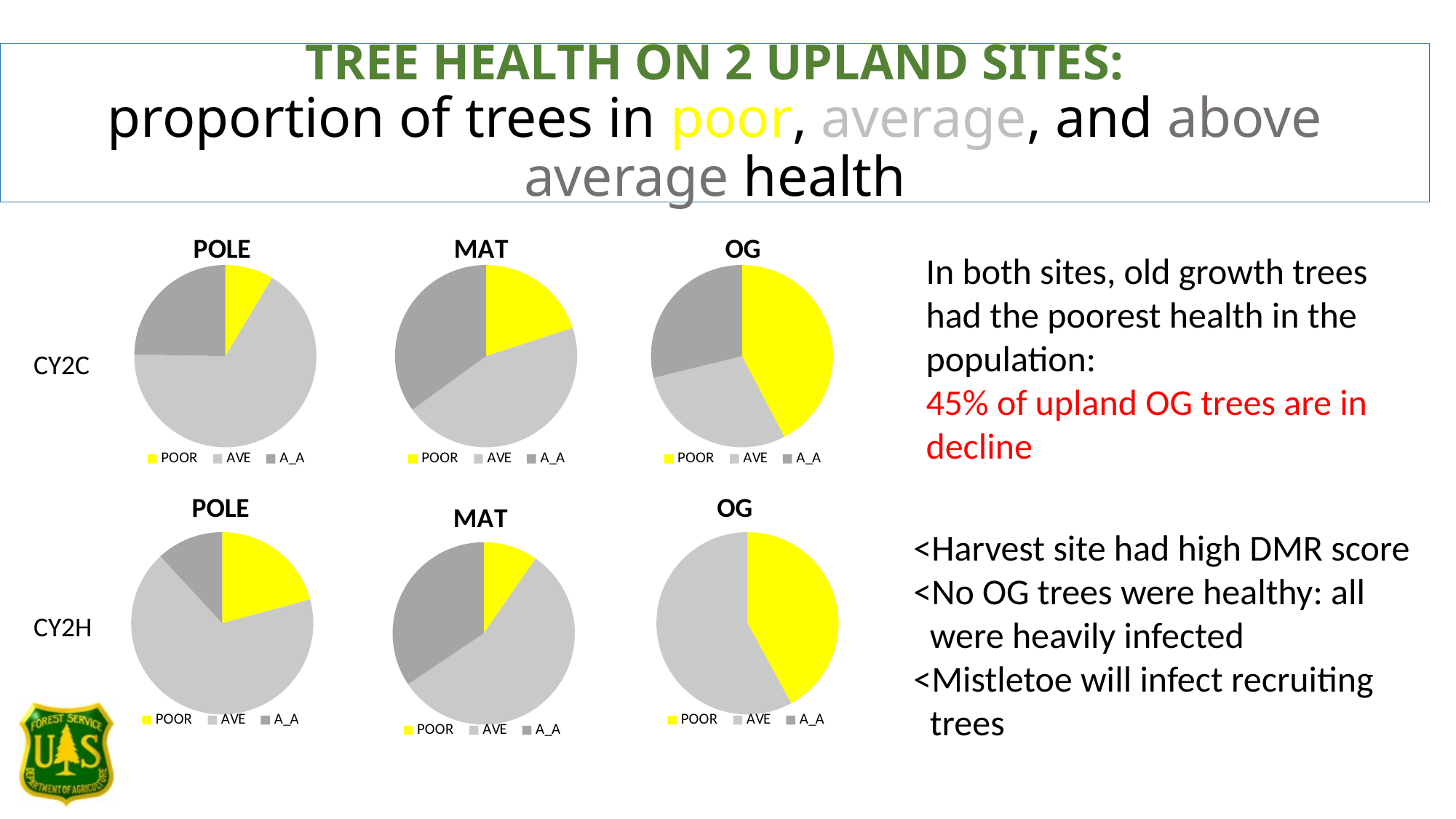
In the CY2H MAT pie chart, which category has the smallest slice? POOR How many slices are visible in the CY2H OG pie chart? 2 What colour represents the POOR category in the pie charts? Yellow In the CY2C OG pie chart, which category has the largest slice? POOR How many entries does the legend of each pie chart list? 3 How many pie charts are on the slide? 6 In the CY2C OG pie chart, which slice is larger, POOR or A_A? POOR In the CY2C POLE pie chart, which category has the smallest slice? POOR What kind of charts are shown on the slide? Pie charts In the CY2C MAT pie chart, which slice is larger, POOR or A_A? A_A In the CY2C POLE pie chart, which category has the largest slice? AVE In the CY2H POLE pie chart, which slice is larger, POOR or A_A? POOR